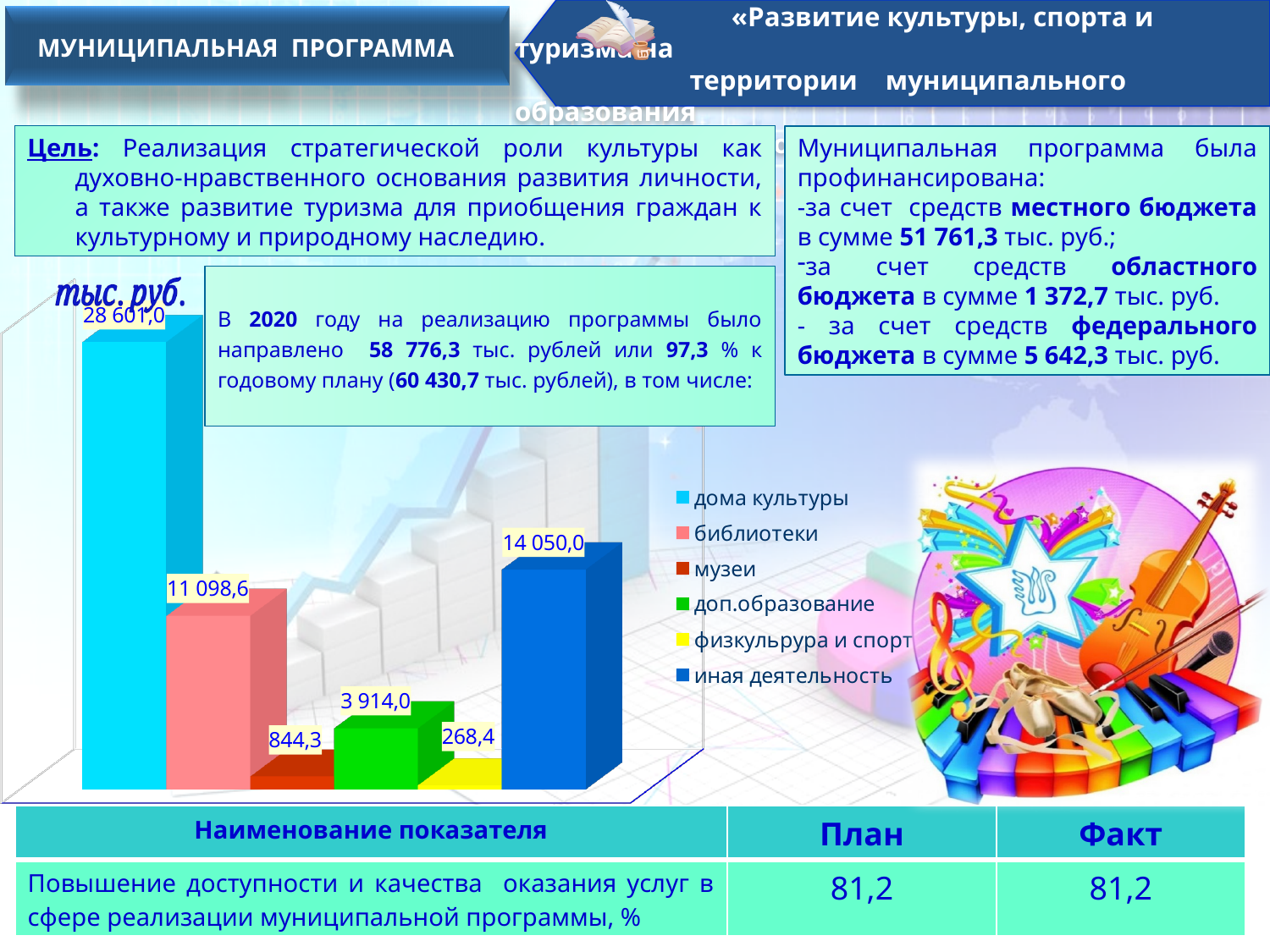
What type of chart is shown on the slide? bar chart What value is shown for библиотеки in the bar chart? 11 098,6 What value is shown for дома культуры in the bar chart? 28 601,0 What is the difference between the values for дома культуры and иная деятельность in the bar chart? 14 551,0 What unit is indicated for the values in the bar chart? тыс. руб. Which category has the lowest value in the bar chart? физкульрура и спорт What value is shown for музеи in the bar chart? 844,3 What value is shown for доп.образование in the bar chart? 3 914,0 How many entries does the legend of the bar chart list? 6 Which category has the highest value in the bar chart? дома культуры Which is larger in the bar chart: библиотеки or иная деятельность? иная деятельность What value is shown for иная деятельность in the bar chart? 14 050,0